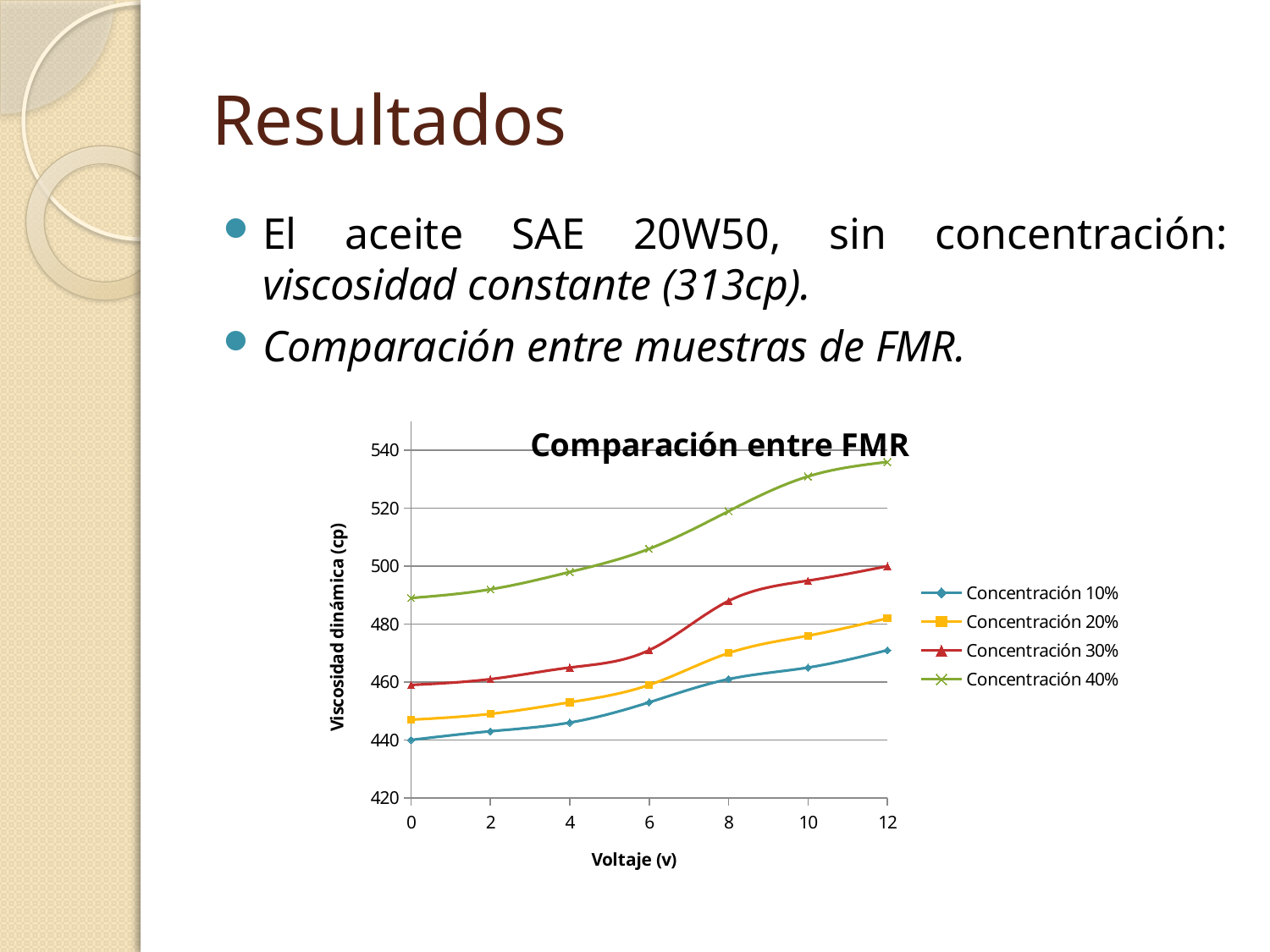
What kind of chart is shown on the slide? Line chart What is the label of the vertical axis of the chart? Viscosidad dinámica (cp) What is the title of the chart? Comparación entre FMR Do the viscosity values for Concentración 40% rise or fall as voltage increases? Rise Which series has the highest viscosity at 12 V? Concentración 40% At 6 V, which series has the larger viscosity, Concentración 20% or Concentración 30%? Concentración 30% Which series has the lowest viscosity at 0 V? Concentración 10% How many voltage points are plotted along the x axis of the chart? 7 How many series does the legend of the chart list? 4 Is the value for Concentración 10% at 12 V greater or less than 480? less Is the value for Concentración 30% at 8 V greater or less than 500? less Is the value for Concentración 40% at 12 V greater or less than 520? greater